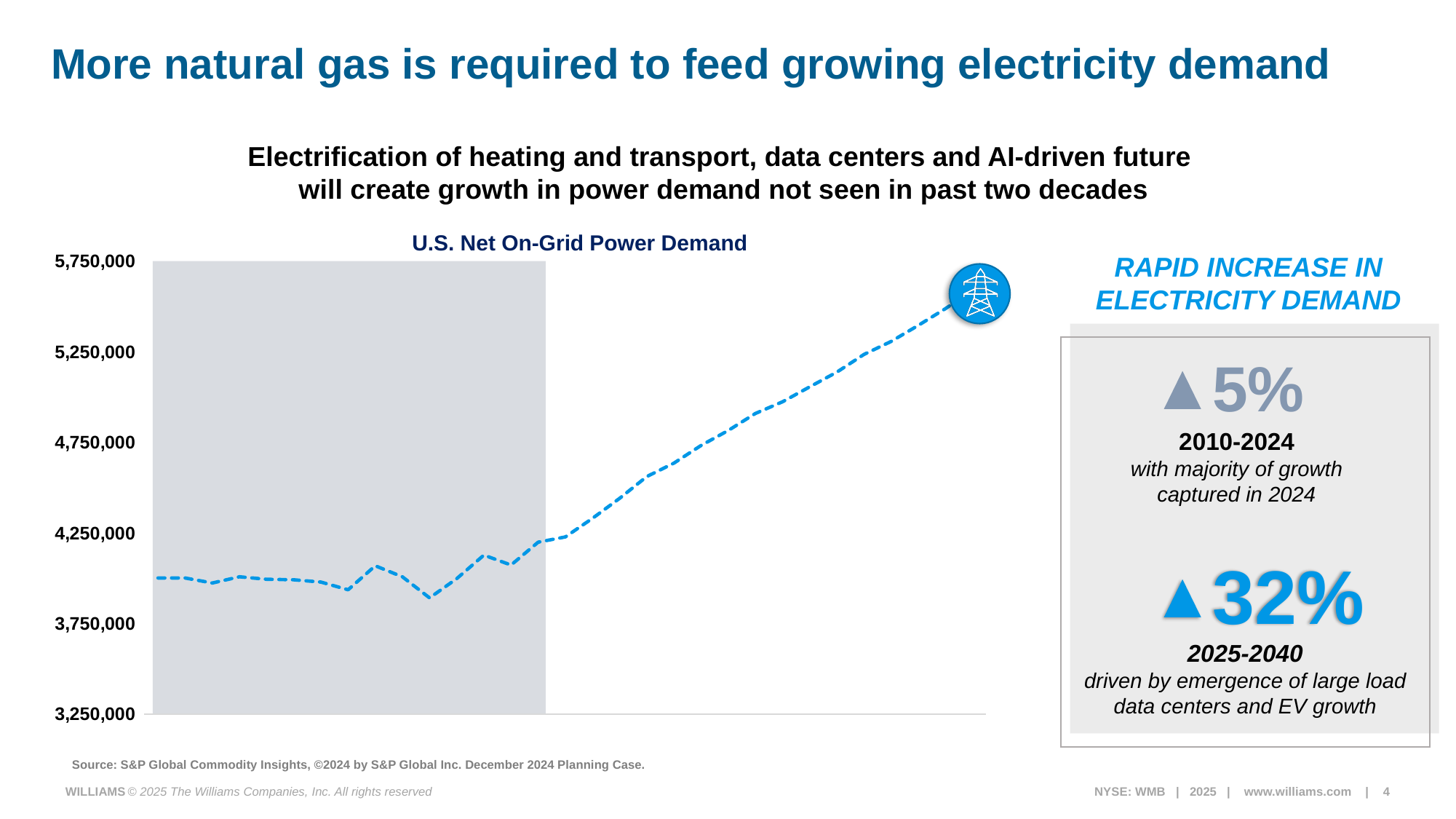
What is the highest value labeled on the vertical axis of the U.S. Net On-Grid Power Demand chart? 5,750,000 Which end of the line in the U.S. Net On-Grid Power Demand chart is higher, the left end or the right end? the right end In the U.S. Net On-Grid Power Demand chart, is the value at the right end of the line greater or less than 5,250,000? greater What is the lowest value labeled on the vertical axis of the U.S. Net On-Grid Power Demand chart? 3,250,000 In the U.S. Net On-Grid Power Demand chart, is the value at the left end of the line greater or less than 3,750,000? greater In the U.S. Net On-Grid Power Demand chart, is the value at the left end of the line greater or less than 4,250,000? less What is the title of the chart on the slide? U.S. Net On-Grid Power Demand What type of chart is shown under the heading "U.S. Net On-Grid Power Demand"? line chart Overall, does the line in the U.S. Net On-Grid Power Demand chart rise or fall from left to right? rise